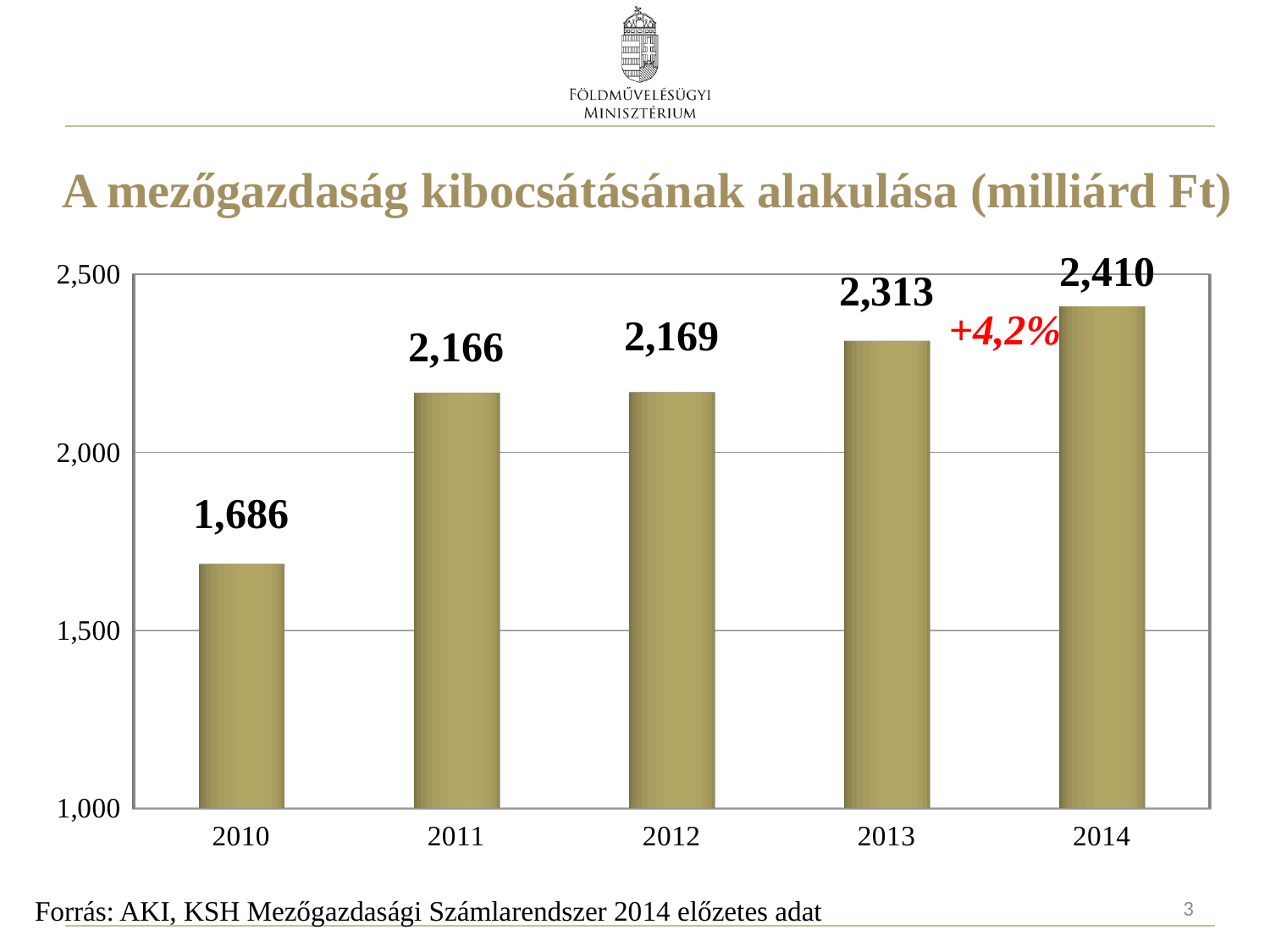
What is the value for 2014? 2,410 What is the difference between the values for 2014 and 2013? 97 What kind of chart is shown on the slide? bar chart What is the value for 2013? 2,313 What is the value for 2010? 1,686 What is the difference between the values for 2011 and 2010? 480 Which year has the highest value? 2014 How many years are shown on the x axis? 5 Do the values rise or fall from 2010 to 2014? rise Which is larger, the value for 2013 or the value for 2011? 2013 Which year has the lowest value? 2010 Is the value for 2010 greater or less than 2,000? less